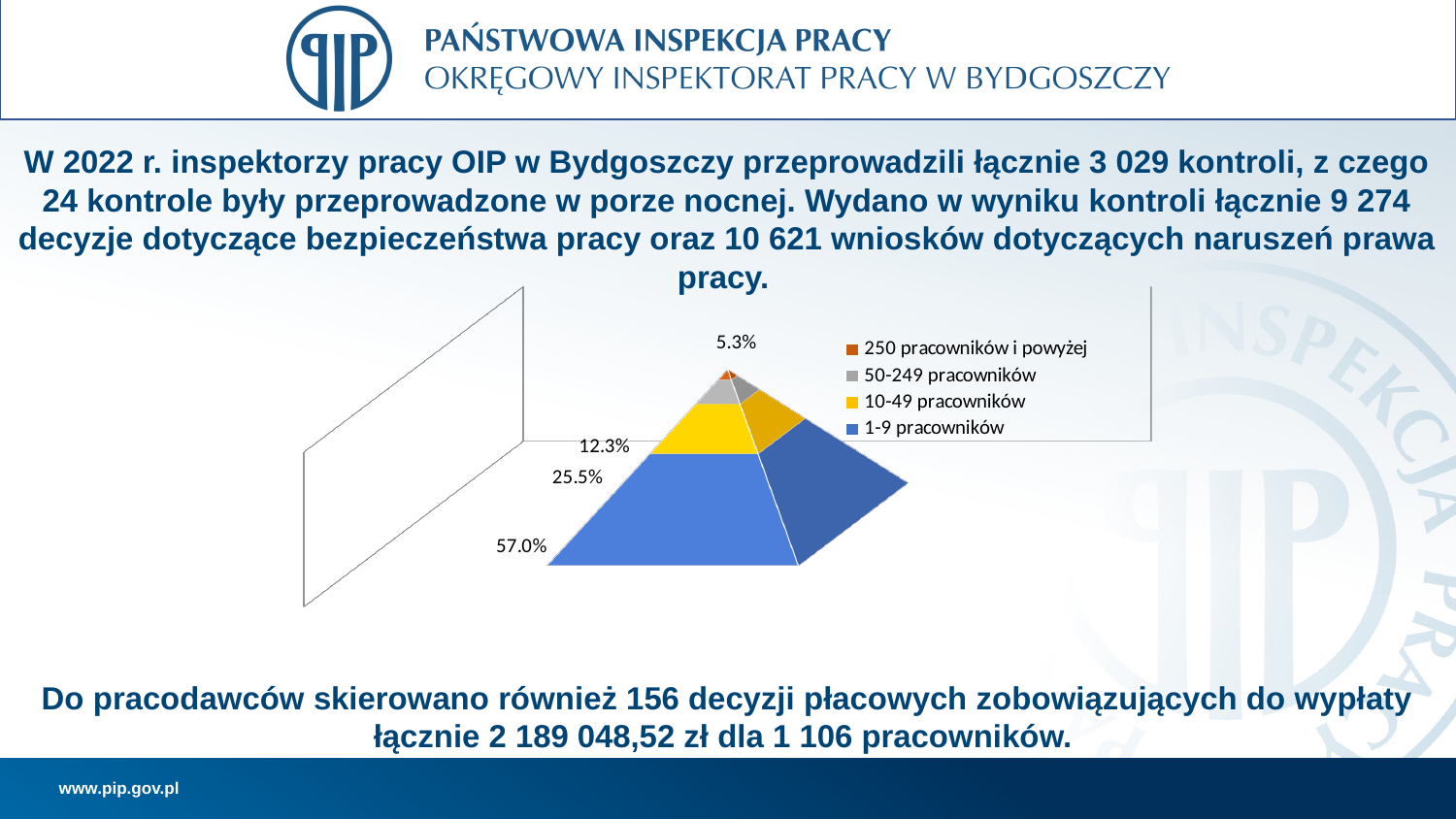
What percentage is shown for the 10-49 pracowników segment? 25.5% What percentage is shown for the 250 pracowników i powyżej segment? 5.3% What colour represents the 10-49 pracowników segment in the chart? Yellow What percentage is shown for the 1-9 pracowników segment? 57.0% Which employer size group has the largest share in the chart? 1-9 pracowników Which employer size group has the smallest share in the chart? 250 pracowników i powyżej What is the difference in percentage points between the 1-9 pracowników and 10-49 pracowników segments? 31.5 percentage points What is the difference in percentage points between the 50-249 pracowników and 250 pracowników i powyżej segments? 7.0 percentage points How many entries does the chart legend list? 4 Which segment is larger: 10-49 pracowników or 50-249 pracowników? 10-49 pracowników What percentage is shown for the 50-249 pracowników segment? 12.3% How many employer size categories does the chart show? 4